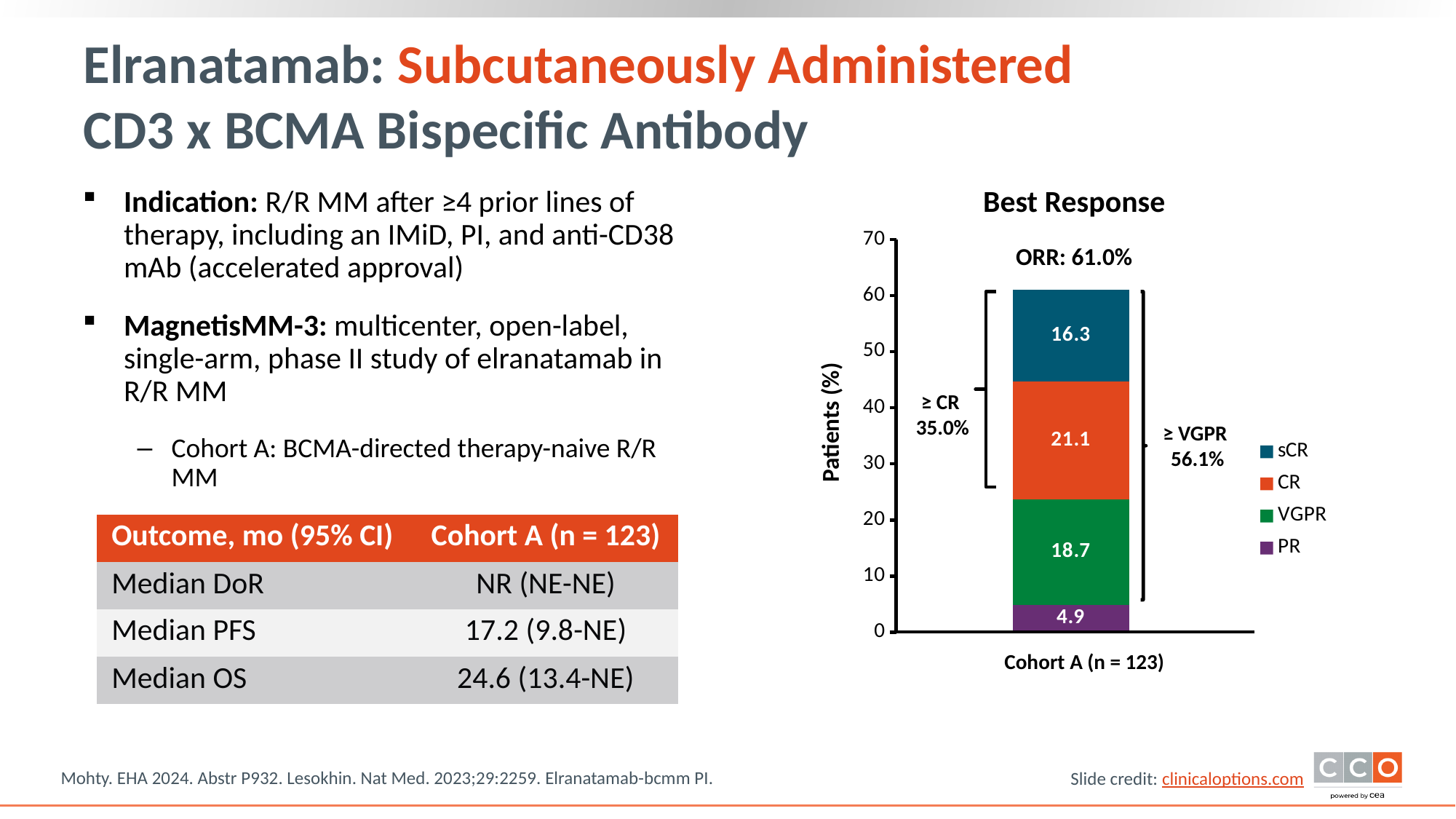
What is the value of the VGPR segment for Cohort A? 18.7 What is the value of the CR segment for Cohort A? 21.1 What is the ORR shown above the Cohort A bar? 61.0% What is the title of the chart? Best Response What is the value of the sCR segment for Cohort A? 16.3 What is the difference between the CR and sCR segment values? 4.8 Which is larger, the VGPR segment or the sCR segment? VGPR How many series does the chart legend list? 4 What is the value of the PR segment for Cohort A? 4.9 What type of chart is shown on the slide? Stacked bar chart Which response category has the largest segment in the Cohort A bar? CR Which response category has the smallest segment in the Cohort A bar? PR